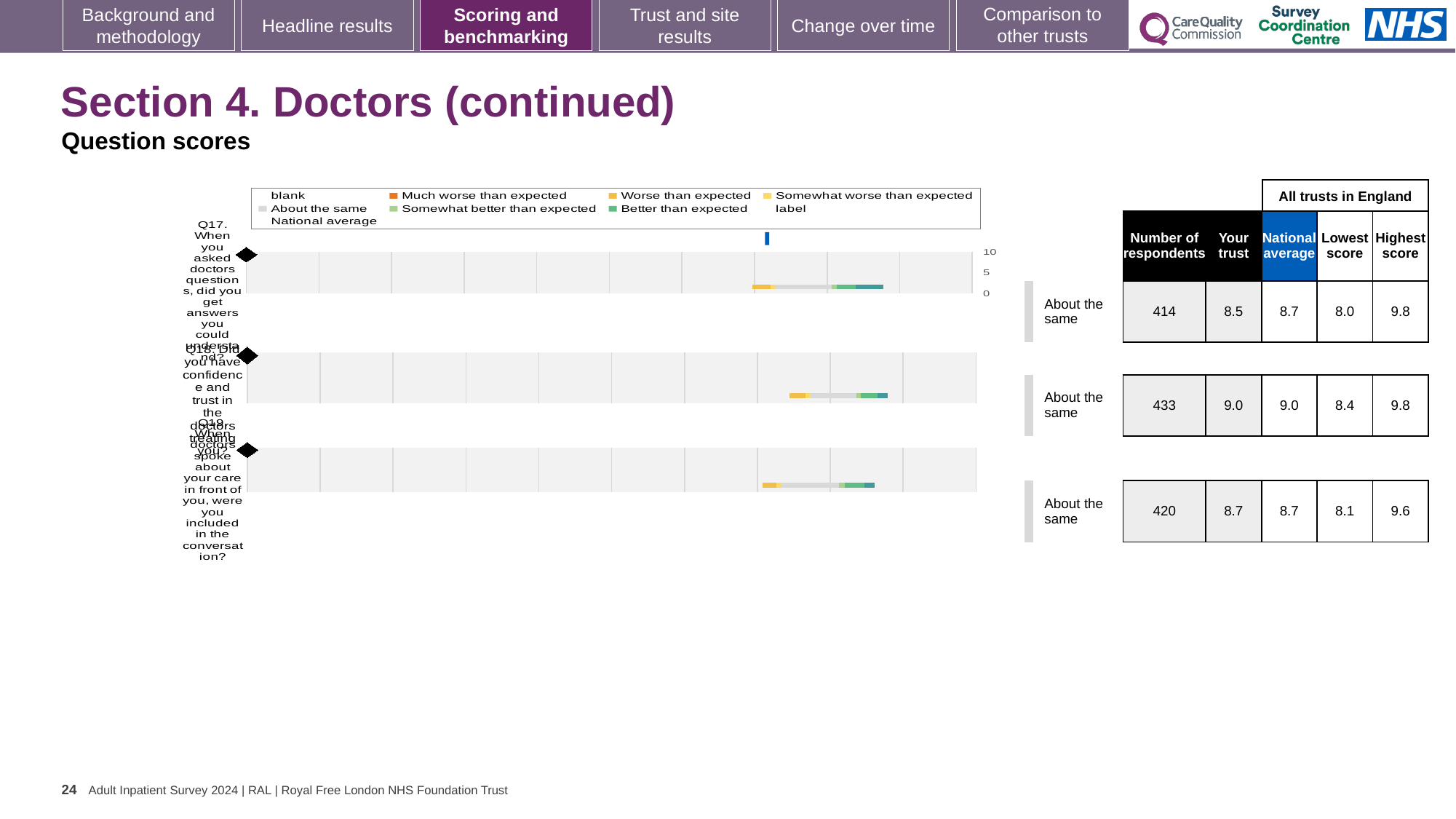
What benchmark category is shown for Q18? About the same What is the difference between the 'Your trust' scores for Q18 and Q17? 0.5 Which question has the lowest 'Your trust' score? Q17 What kind of chart is used to show the question scores? bar chart What is the national average score for Q17? 8.7 Which question has the highest 'Your trust' score? Q18 In the chart legend, which category is shown in dark orange? Much worse than expected How many questions are plotted as bars in the chart? 3 What is the 'Your trust' score for Q18? 9.0 What is the highest score among all trusts in England for Q19? 9.6 How many respondents answered Q19? 420 Which has the larger 'Your trust' score, Q17 or Q19? Q19